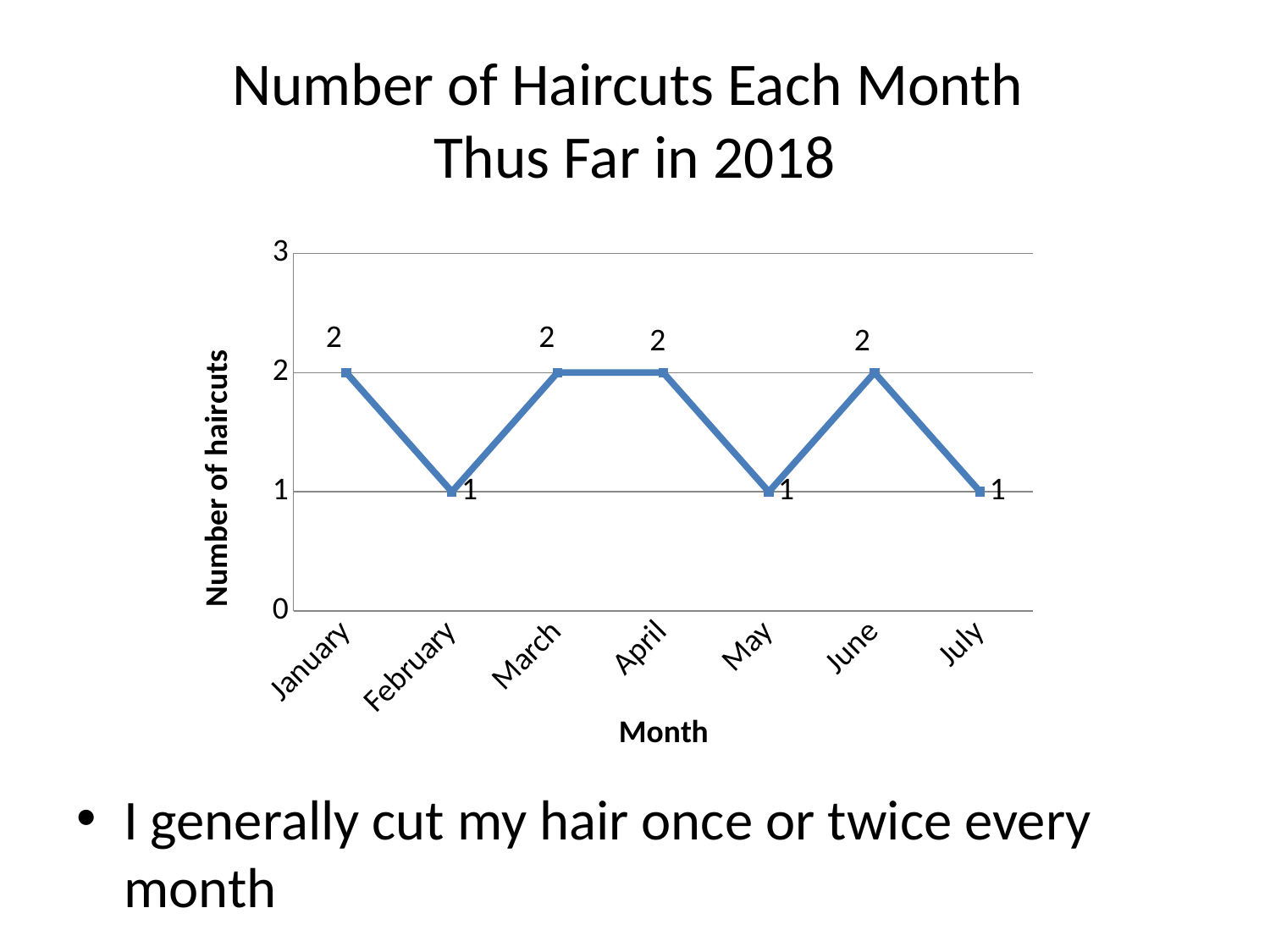
How many months are plotted on the chart? 7 What kind of chart is shown on the slide? line chart How many haircuts were there in February? 1 How many haircuts were there in January? 2 What is the difference between the number of haircuts in March and in February? 1 What is the label on the horizontal axis? Month How many haircuts were there in May? 1 Which month had more haircuts, April or May? April Which month had more haircuts, June or July? June What is the label on the vertical axis? Number of haircuts How many haircuts were there in June? 2 Do the number of haircuts rise or fall from June to July? fall